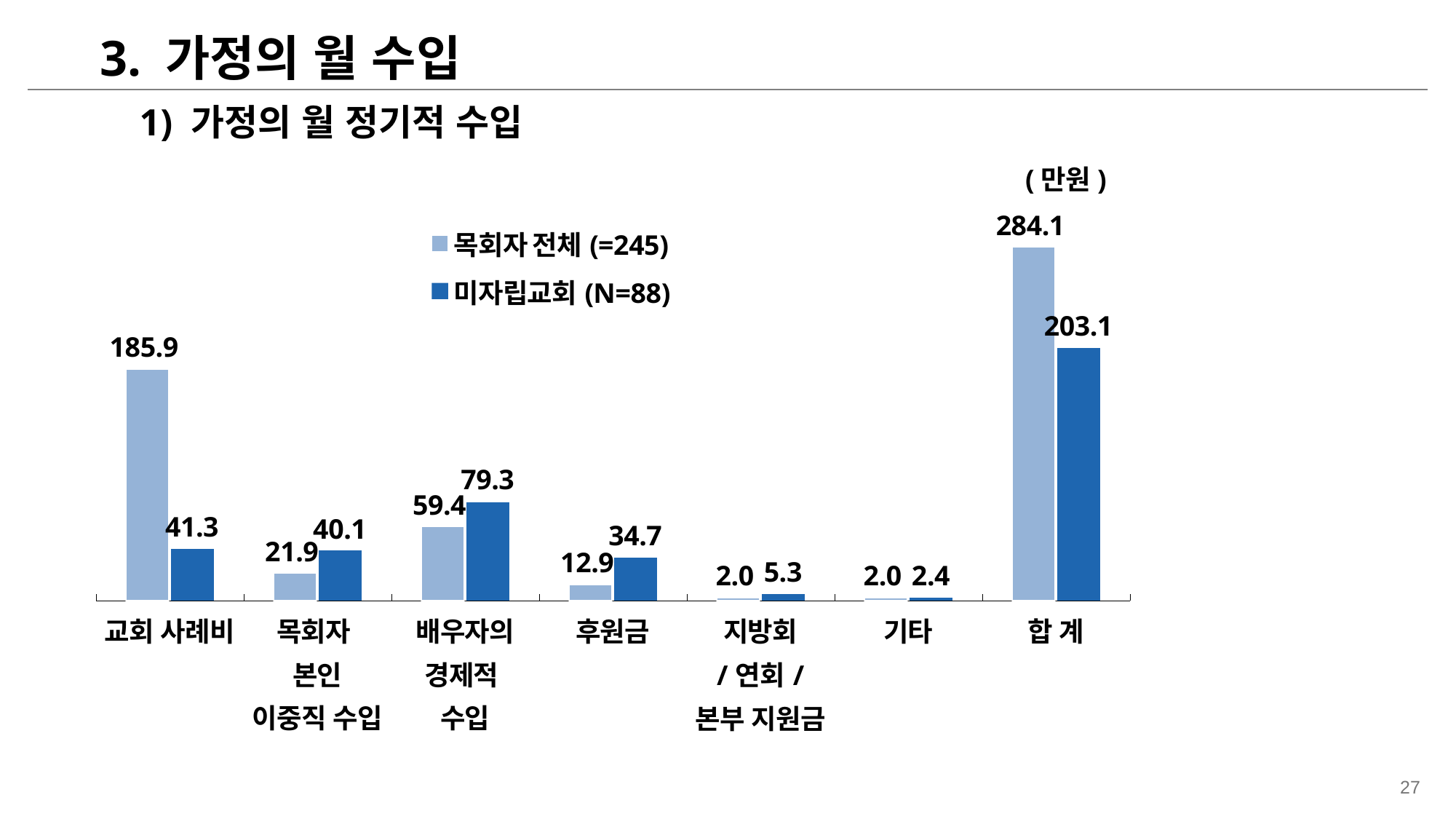
What is the 합 계 value for the 미자립교회 (N=88) series? 203.1 What is the difference between the 합 계 values of the two series? 81.0 What is the value for 배우자의 경제적 수입 in the 미자립교회 (N=88) series? 79.3 How many categories are shown on the x axis? 7 What is the difference between the 목회자 전체 (=245) and 미자립교회 (N=88) values for 교회 사례비? 144.6 Excluding 합 계, which category has the lowest value in the 미자립교회 (N=88) series? 기타 Excluding 합 계, which category has the highest value in the 목회자 전체 (=245) series? 교회 사례비 What kind of chart is shown on the slide? Bar chart What is the value for 후원금 in the 목회자 전체 (=245) series? 12.9 What is the value for 교회 사례비 in the 목회자 전체 (=245) series? 185.9 How many series does the legend list? 2 For 목회자 본인 이중직 수입, which series has the larger value? 미자립교회 (N=88)